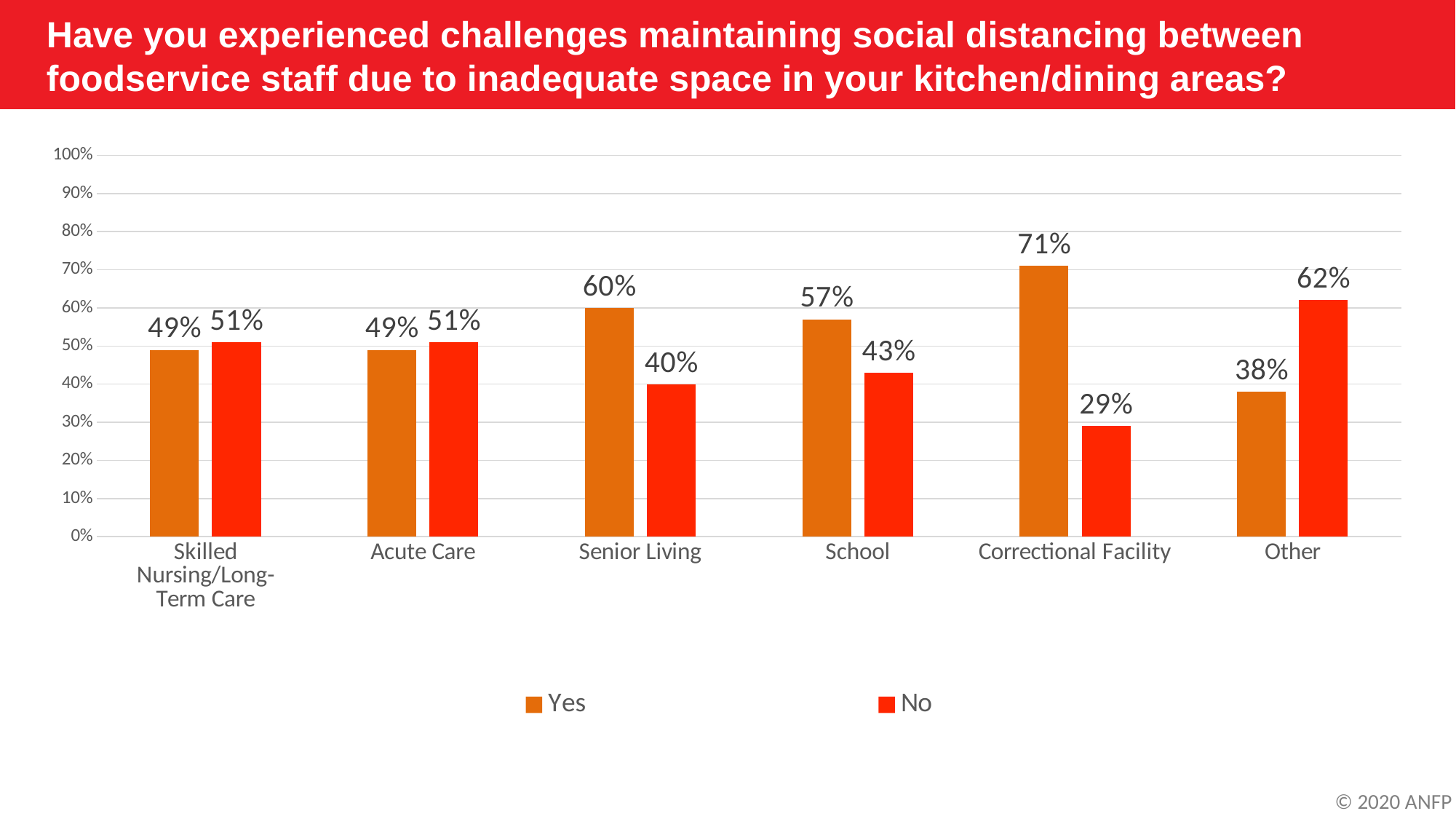
What is the Yes value for Other? 38% What is the No value for Senior Living? 40% What percentage of Correctional Facility respondents answered Yes? 71% How many series does the legend list? 2 For Other, which is larger, the Yes value or the No value? No Is the Yes value for Senior Living greater or less than 50%? greater What kind of chart is shown on the slide? Bar chart Which category has the highest Yes value? Correctional Facility What colour represents the No series in the legend? Red What is the difference between the Yes and No values for School? 14% How many categories are shown on the x axis? 6 Which category has the lowest No value? Correctional Facility